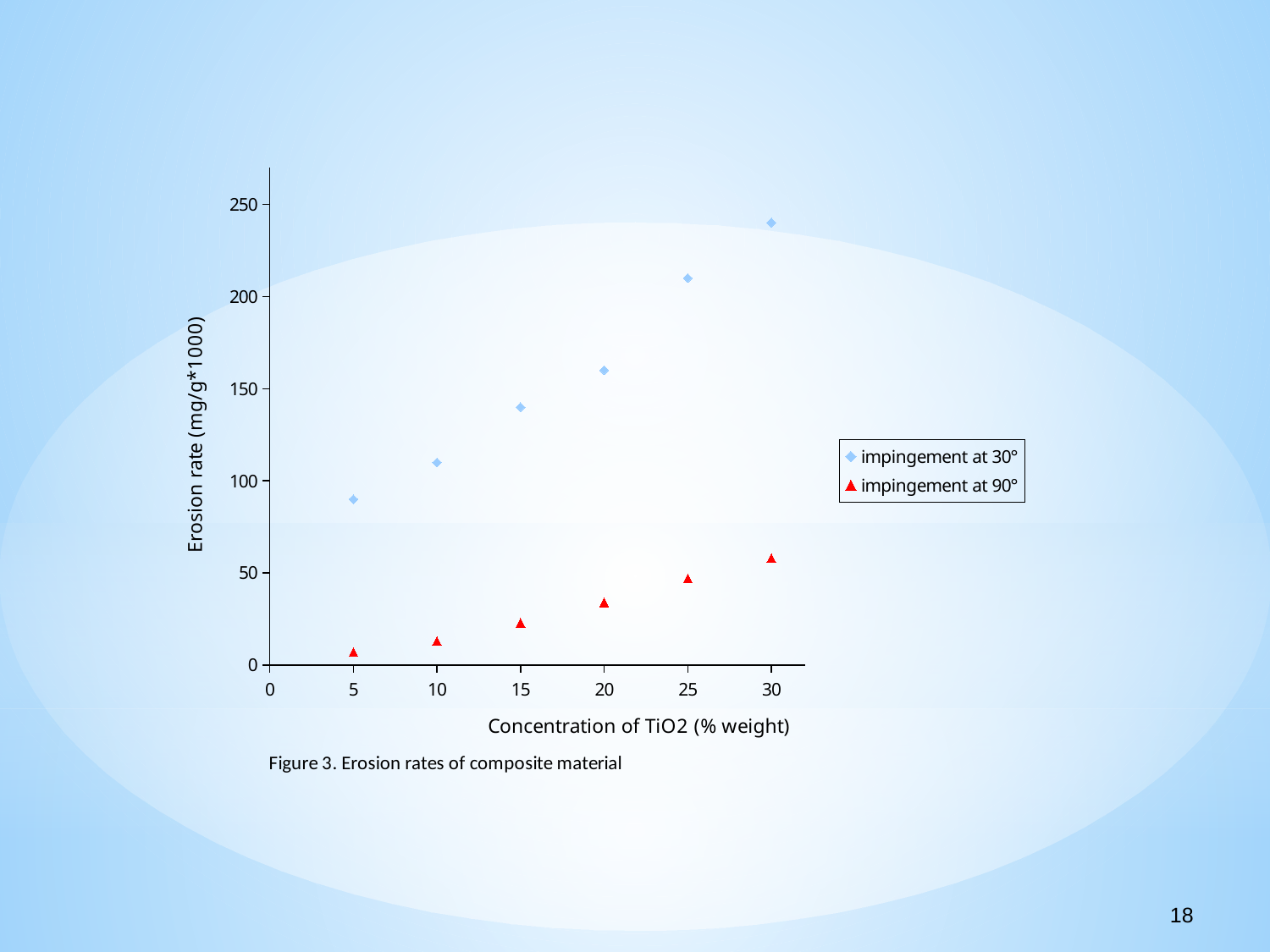
Is the erosion rate for 'impingement at 30°' at 20% TiO2 greater or less than 150? greater Is the erosion rate for 'impingement at 30°' at 5% TiO2 greater or less than 100? less Is the erosion rate for 'impingement at 90°' at 5% TiO2 greater or less than 50? less How many series does the legend list? 2 Does the erosion rate for 'impingement at 90°' rise or fall as the concentration of TiO2 increases? rise At which TiO2 concentration is the erosion rate for 'impingement at 30°' highest? 30 What kind of chart is shown on the slide? scatter chart How many data points are plotted for the 'impingement at 30°' series? 6 At 20% TiO2, which series has the higher erosion rate, 'impingement at 30°' or 'impingement at 90°'? impingement at 30° At which TiO2 concentration is the erosion rate for 'impingement at 90°' lowest? 5